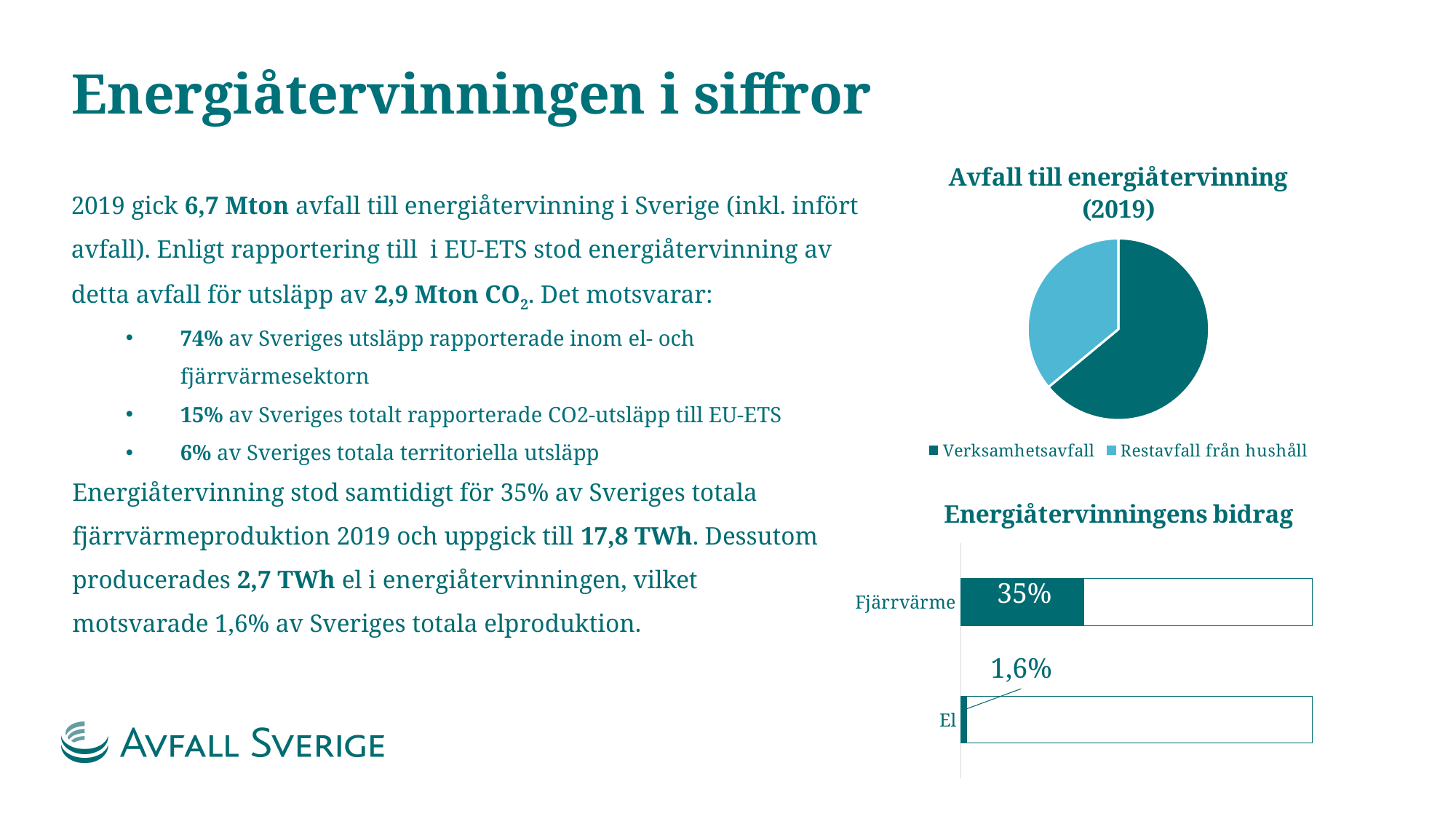
In the "Energiåtervinningens bidrag" chart, what is the difference between the Fjärrvärme and El values? 33,4% In the "Energiåtervinningens bidrag" chart, which category has the highest value? Fjärrvärme In the "Energiåtervinningens bidrag" chart, what is the value for Fjärrvärme? 35% How many categories are shown in the "Energiåtervinningens bidrag" chart? 2 In the "Avfall till energiåtervinning (2019)" chart, how many entries does the legend list? 2 What kind of chart is the "Avfall till energiåtervinning (2019)" chart? pie chart What kind of chart is the "Energiåtervinningens bidrag" chart? bar chart In the "Avfall till energiåtervinning (2019)" chart, what colour is the Restavfall från hushåll slice? light blue In the "Avfall till energiåtervinning (2019)" chart, which slice is larger, Verksamhetsavfall or Restavfall från hushåll? Verksamhetsavfall In the "Energiåtervinningens bidrag" chart, which category has the lowest value? El In the "Avfall till energiåtervinning (2019)" chart, which category has the smallest slice? Restavfall från hushåll In the "Energiåtervinningens bidrag" chart, what is the value for El? 1,6%